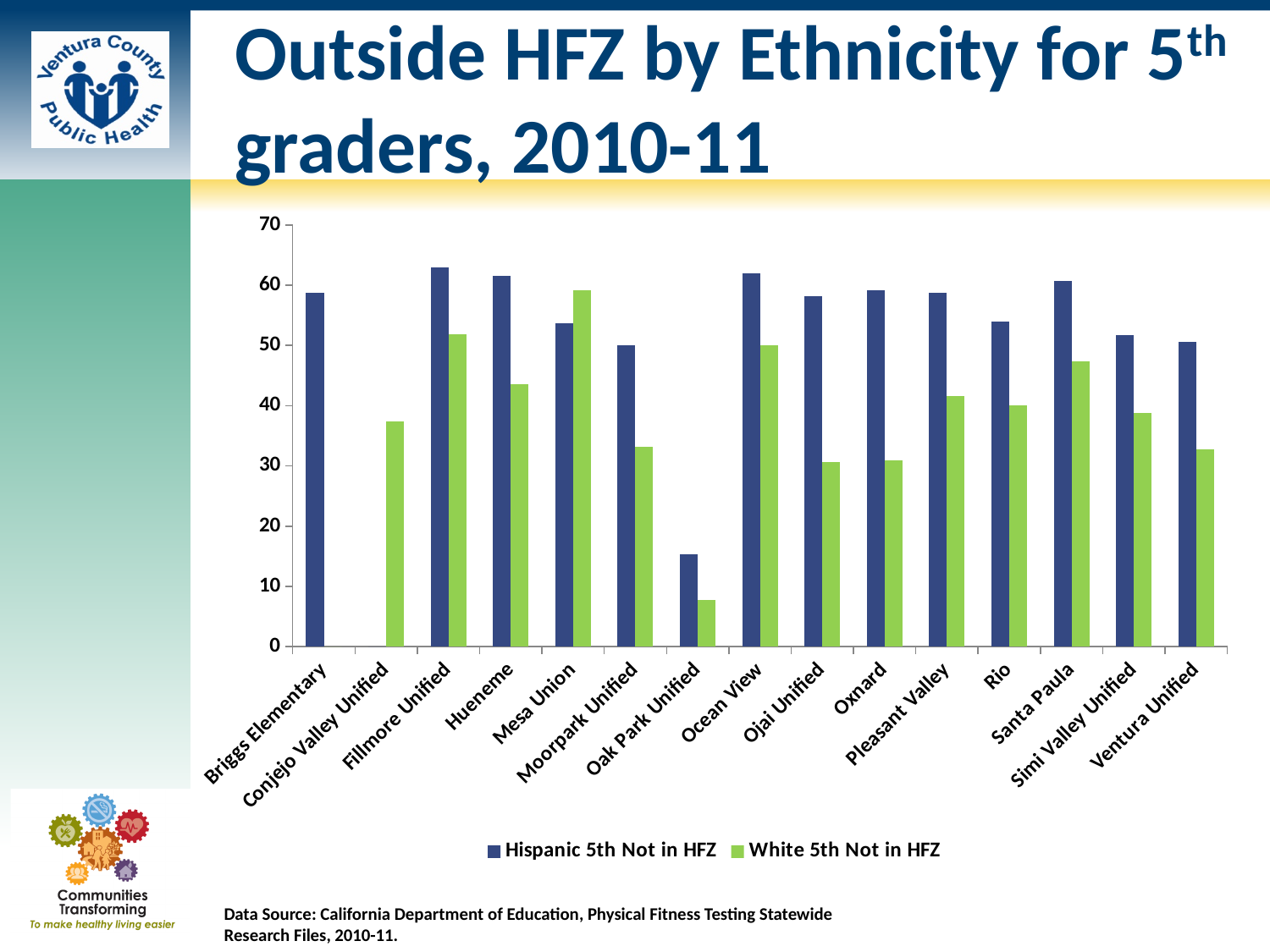
Which district has the highest value for White 5th Not in HFZ? Mesa Union Is the value for White 5th Not in HFZ at Santa Paula greater or less than 50? less Is the value for Hispanic 5th Not in HFZ at Oak Park Unified greater or less than 20? less At Mesa Union, which series has the larger value: Hispanic 5th Not in HFZ or White 5th Not in HFZ? White 5th Not in HFZ Which colour represents the White 5th Not in HFZ series? green How many series does the legend list? 2 What kind of chart is shown on the slide? bar chart Is the value for Hispanic 5th Not in HFZ at Briggs Elementary greater or less than 50? greater How many school districts are shown on the x axis? 15